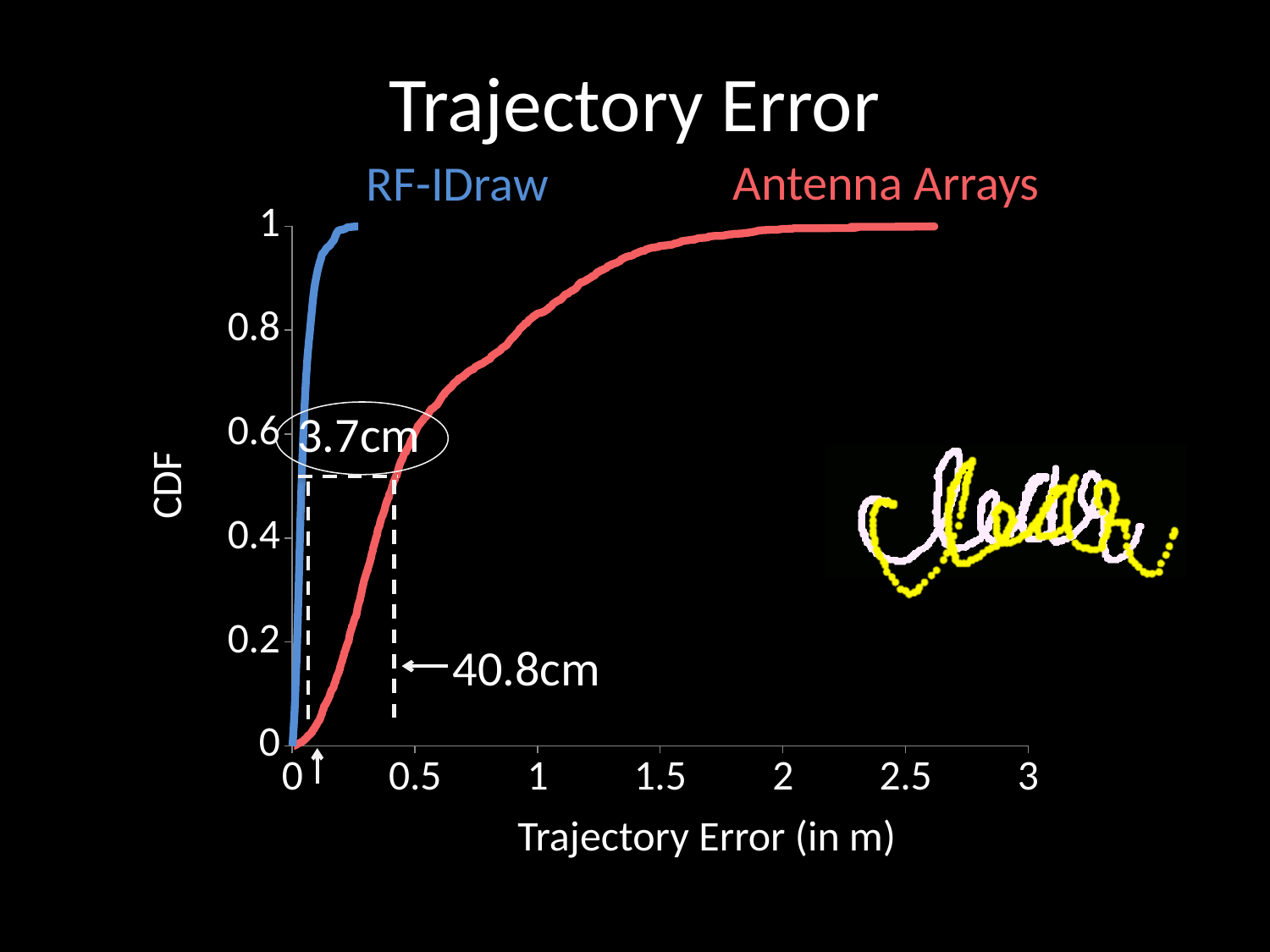
What kind of chart is shown on the slide? line chart Is the CDF value for Antenna Arrays at a trajectory error of 1 m greater or less than 0.6? greater Do the CDF values rise or fall as trajectory error increases along the x axis? rise What median trajectory error is annotated for Antenna Arrays? 40.8cm Which series is drawn in blue? RF-IDraw What is the label of the x axis? Trajectory Error (in m) What median trajectory error is annotated for RF-IDraw? 3.7cm How many series are plotted on the chart? 2 What is the label of the y axis? CDF Which series has the larger annotated median trajectory error, RF-IDraw or Antenna Arrays? Antenna Arrays What is the difference between the two annotated median trajectory errors? 37.1cm